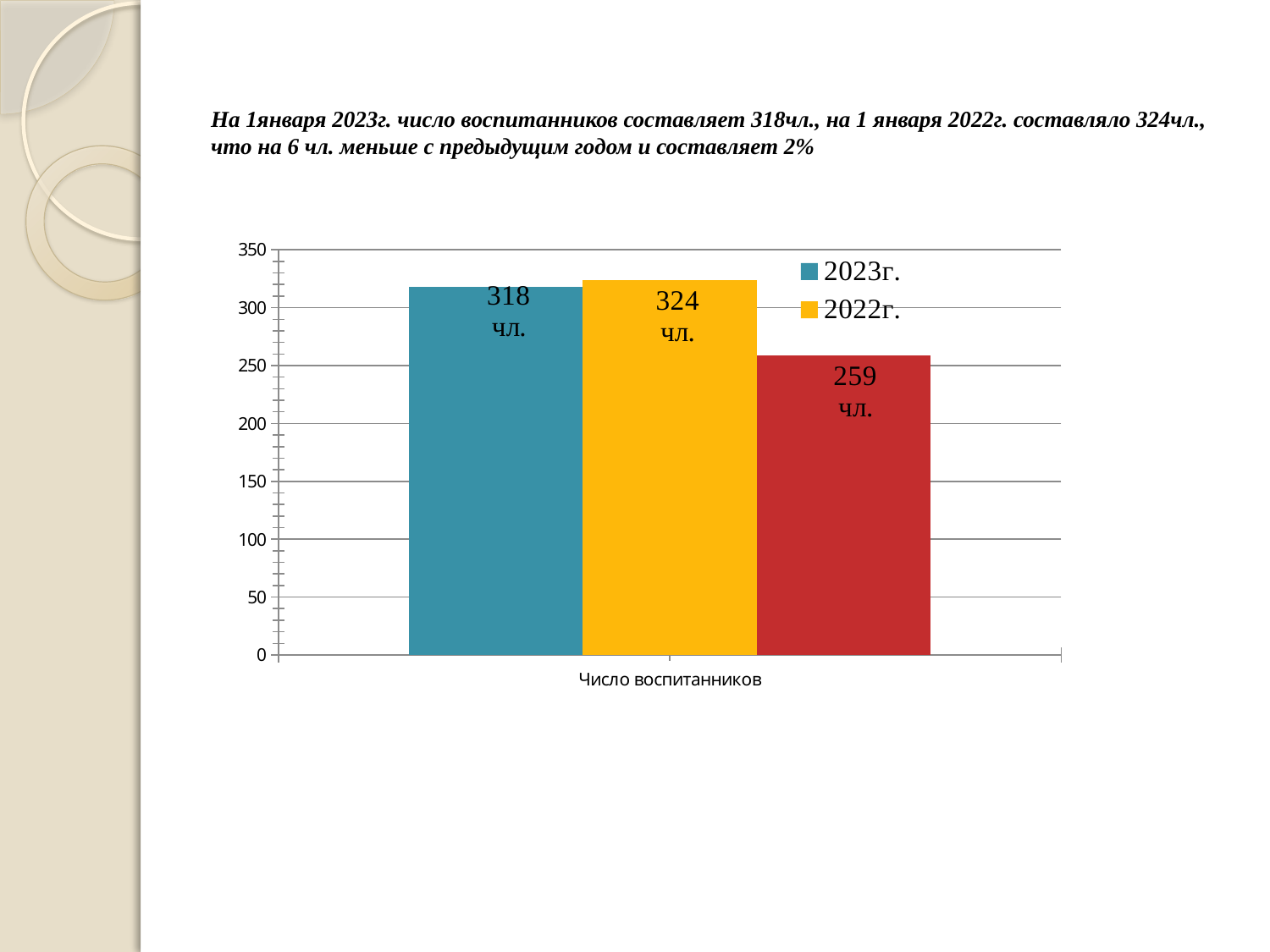
Which is larger, the value for 2023г. or the value for 2022г.? 2022г. What is the value for 2022г. in the chart? 324 чл. What value is printed on the red bar in the chart? 259 чл. How many series does the legend list? 2 What is the difference between the values for 2022г. and 2023г.? 6 Which bar has the lowest value? The red bar (259 чл.) What is the difference between the value for 2023г. and the value on the red bar? 59 What is the value for 2023г. in the chart? 318 чл. Which of the three bars has the highest value? 2022г. What is the category label shown on the x axis? Число воспитанников What kind of chart is shown on the slide? Bar chart Is the value of the red bar greater or less than 250? greater